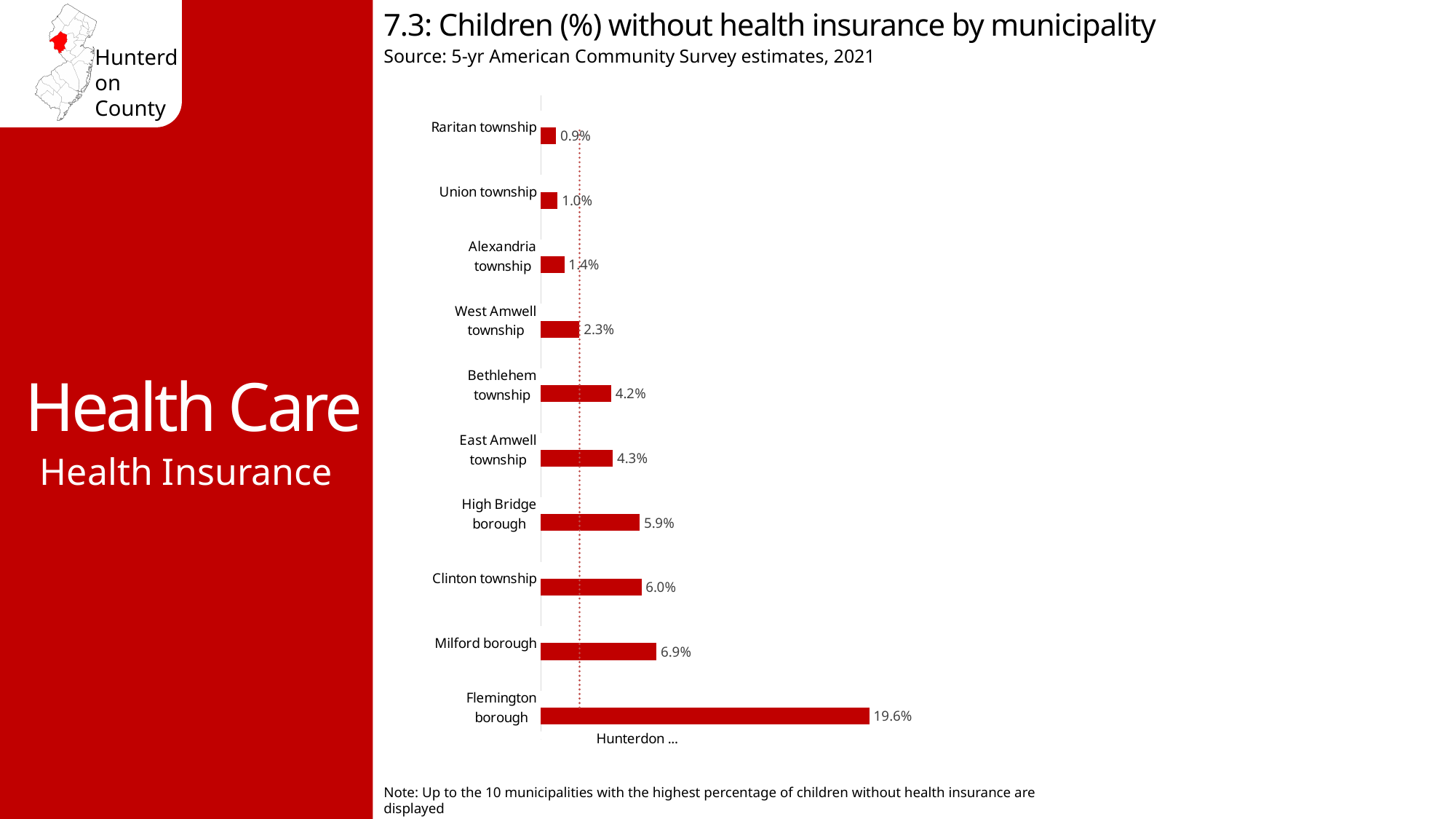
What is the value shown for Bethlehem township? 4.2% Which has a higher value, Milford borough or Clinton township? Milford borough What is the value shown for Clinton township? 6.0% What is the difference between the values for High Bridge borough and West Amwell township? 3.6% Which has a higher value, Bethlehem township or Union township? Bethlehem township Which municipality has the highest percentage of children without health insurance? Flemington borough What is the title of the chart? 7.3: Children (%) without health insurance by municipality How many municipalities are shown in the chart? 10 What type of chart is used on this slide? Bar chart Which municipality has the lowest percentage of children without health insurance? Raritan township What percentage of children are without health insurance in Flemington borough? 19.6% What is the difference between the values for Flemington borough and Milford borough? 12.7%